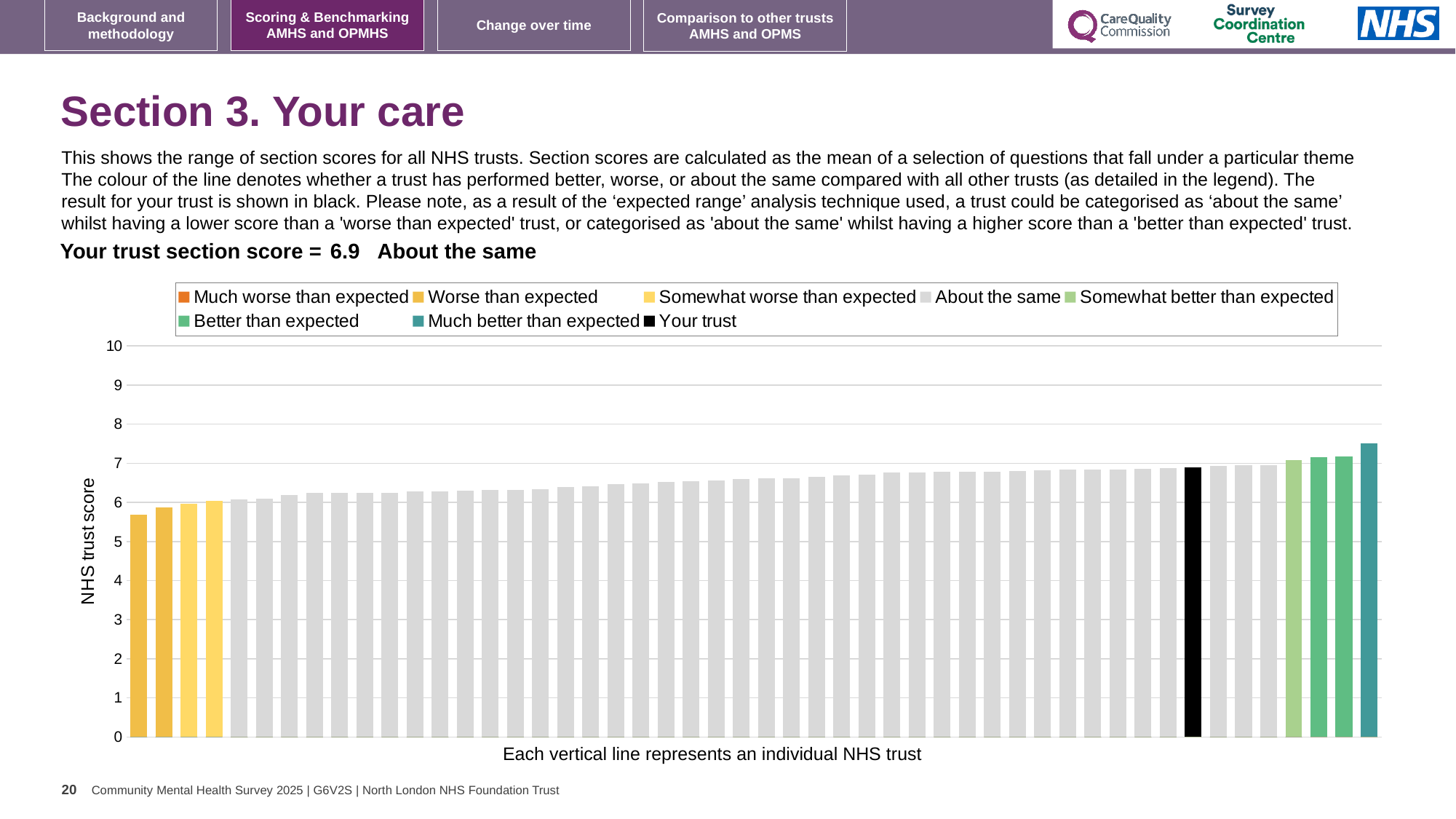
How many entries does the chart legend list? 8 Which category does your trust fall into according to the slide? About the same What kind of chart is shown on the slide? bar chart How many bars are shown in the 'Worse than expected' colour? 2 What is the section score for your trust shown on the slide? 6.9 What colour is the bar representing your trust? black Do the bar values rise or fall from left to right along the x axis? rise Is the value of the tallest bar in the chart greater or less than 7? greater What is the label of the y axis? NHS trust score Is the value of the lowest bar in the chart greater or less than 6? less How many bars are shown in the 'Much better than expected' colour? 1 Is the value for your trust greater or less than 6? greater